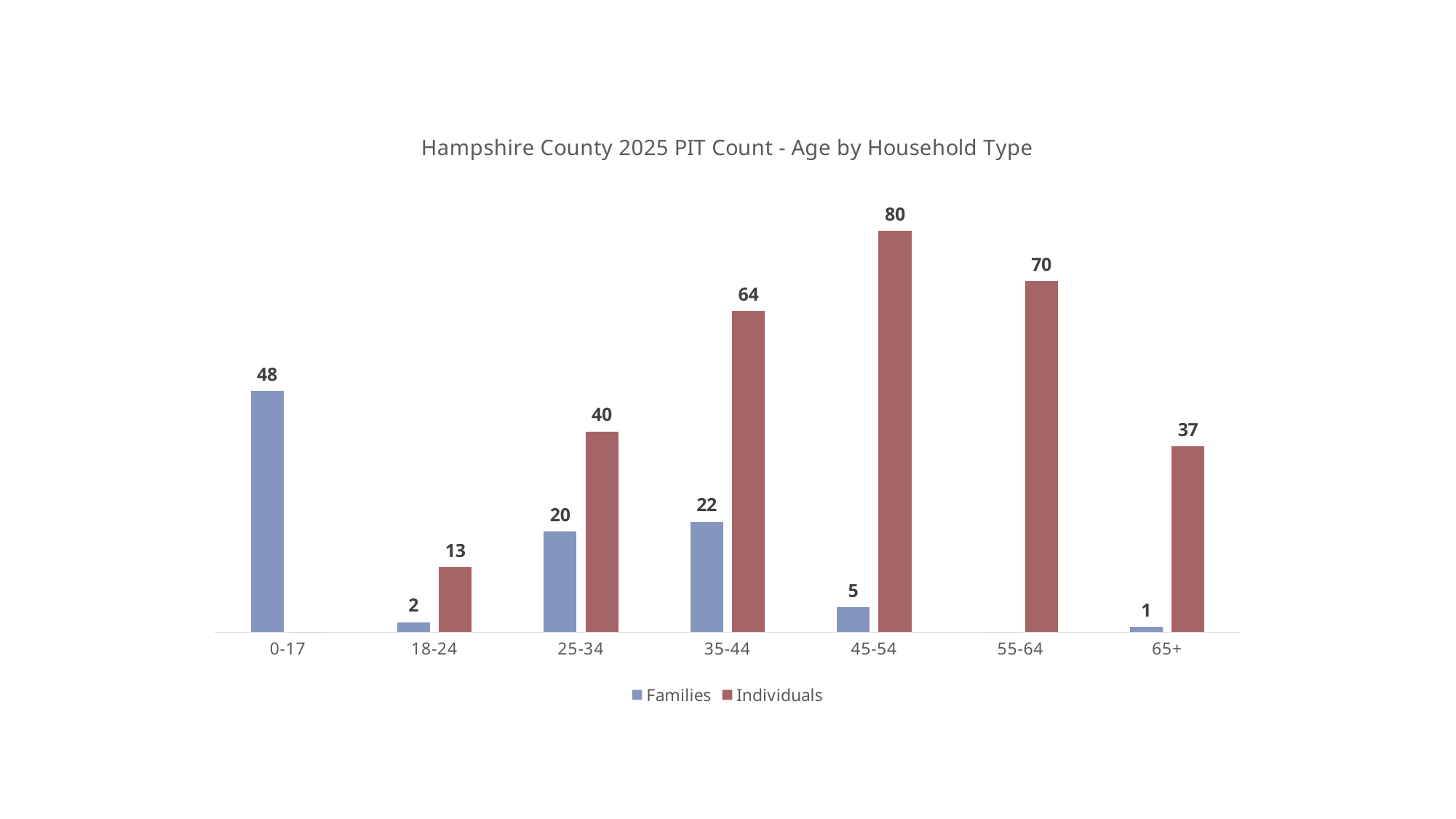
Which is larger for the 25-34 age group, Families or Individuals? Individuals How many age groups are shown on the x axis? 7 What is the difference between the Individuals values for 45-54 and 55-64? 10 What is the Families value for the 0-17 age group? 48 Which age group has the highest Individuals value? 45-54 How many series does the legend list? 2 What is the Individuals value for the 65+ age group? 37 What kind of chart is shown on the slide? Bar chart Which age group has the lowest Families value among those with a Families bar? 65+ What is the difference between the Individuals and Families values for the 35-44 age group? 42 What is the title of the chart? Hampshire County 2025 PIT Count - Age by Household Type What is the Individuals value for the 45-54 age group? 80